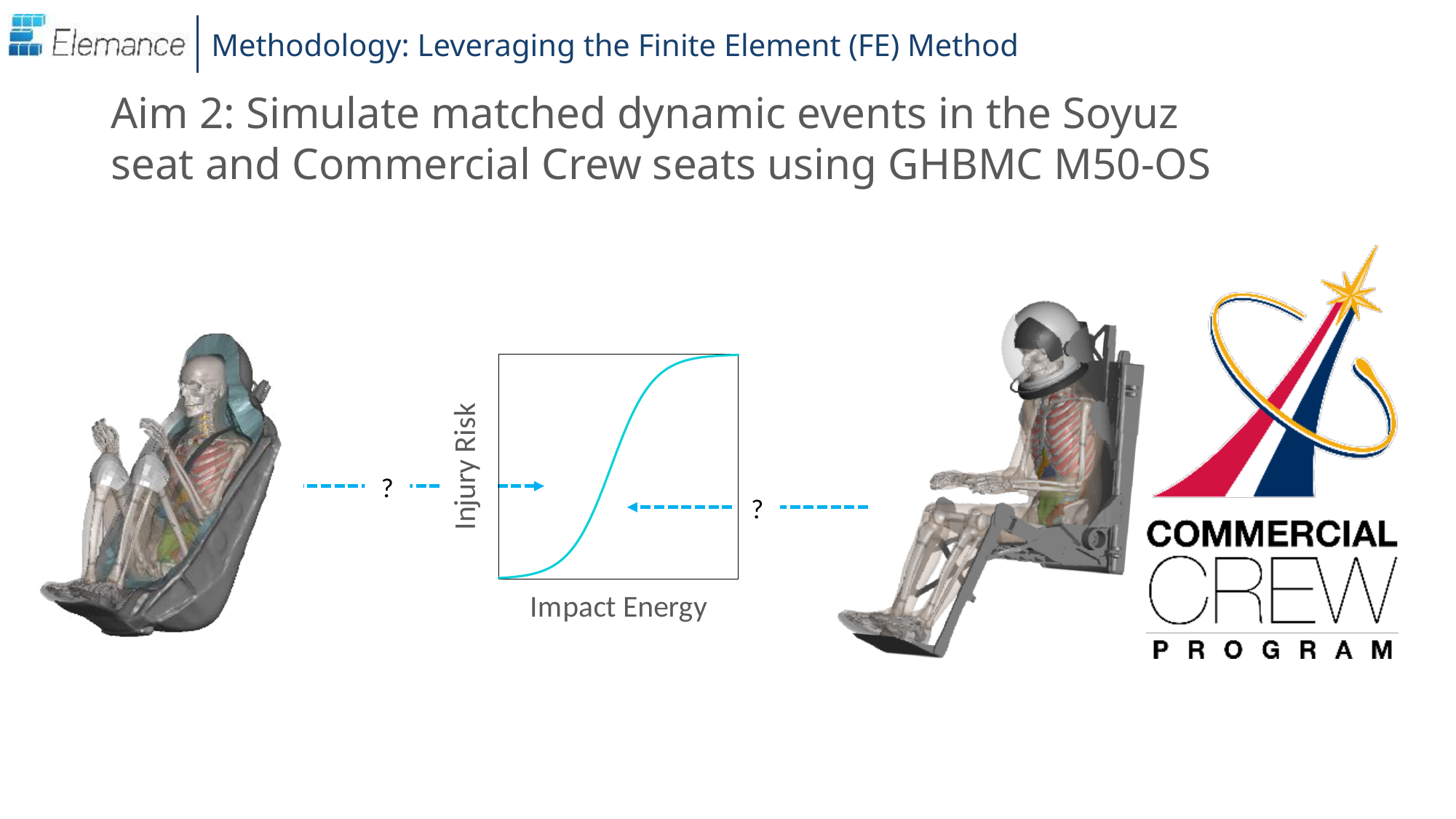
As Impact Energy increases along the x axis, does Injury Risk rise or fall? rises What kind of chart is shown between the two seat models? line chart How many curves are plotted on the chart? 1 What is the label on the x axis of the chart? Impact Energy What is the label on the y axis of the chart? Injury Risk